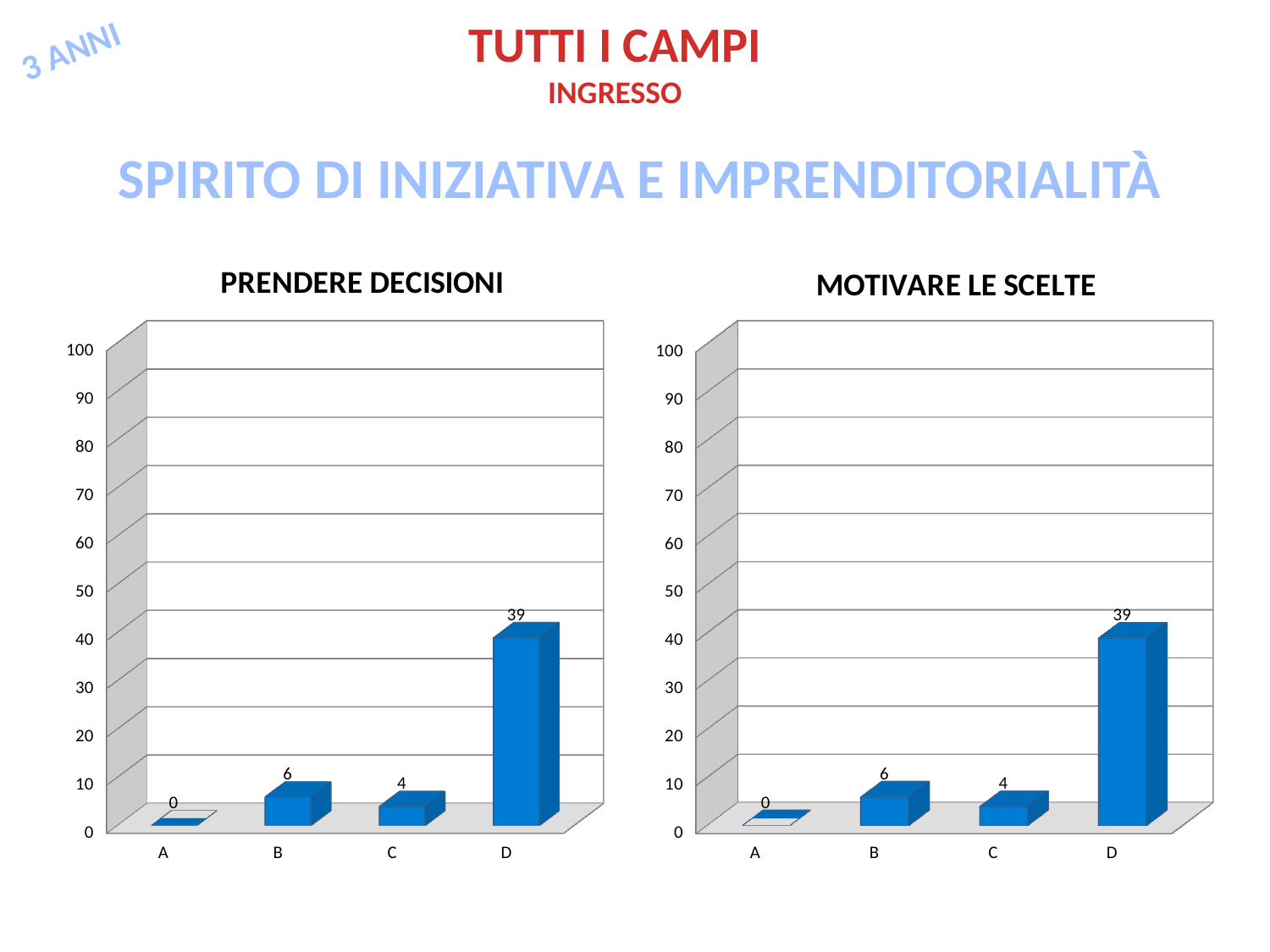
In the PRENDERE DECISIONI chart, which category has the lowest value? A In the MOTIVARE LE SCELTE chart, what is the value for category B? 6 In the MOTIVARE LE SCELTE chart, which category has the highest value? D In the PRENDERE DECISIONI chart, what is the difference between the values for D and B? 33 In the MOTIVARE LE SCELTE chart, which is larger, the value for B or the value for C? B In the PRENDERE DECISIONI chart, what is the value for category D? 39 What kind of chart is the PRENDERE DECISIONI chart? bar chart In the MOTIVARE LE SCELTE chart, what is the difference between the values for B and C? 2 In the PRENDERE DECISIONI chart, is the value for D greater or less than 50? less In the PRENDERE DECISIONI chart, what is the value for category A? 0 What is the title of the chart on the right side of the slide? MOTIVARE LE SCELTE How many categories are shown in the MOTIVARE LE SCELTE chart? 4